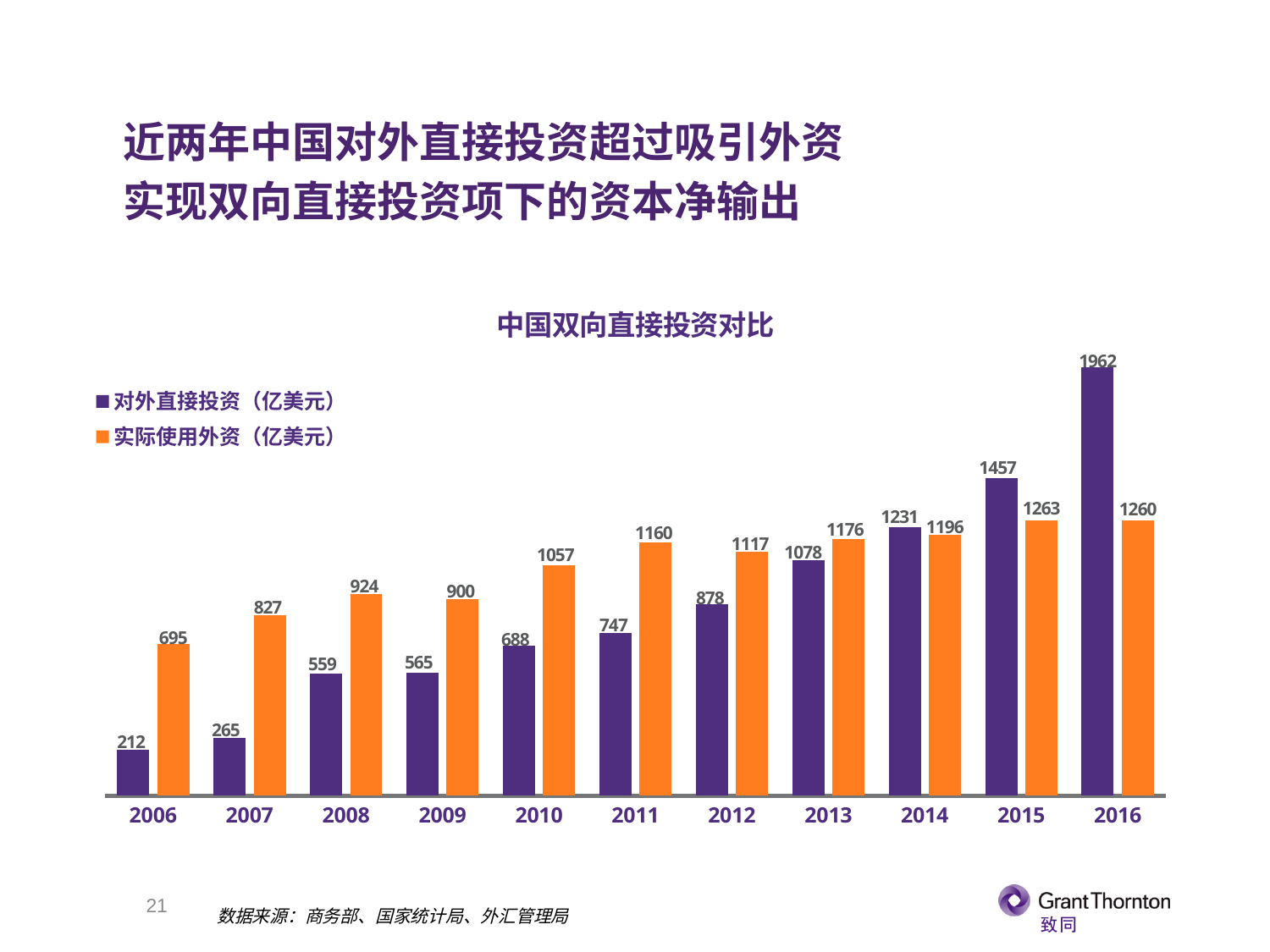
What is the value of 对外直接投资 (亿美元) in 2016? 1962 How many years are shown on the x axis? 11 In 2012, which is larger: 对外直接投资 or 实际使用外资? 实际使用外资 Which year has the highest value for 对外直接投资 (亿美元)? 2016 Which year has the lowest value for 实际使用外资 (亿美元)? 2006 What kind of chart is shown? Bar chart Does 对外直接投资 (亿美元) rise or fall from 2006 to 2016? Rise What is the value of 实际使用外资 (亿美元) in 2010? 1057 What is the value of 对外直接投资 (亿美元) in 2006? 212 How many series does the legend list? 2 What is the title of the chart? 中国双向直接投资对比 What is the difference between 对外直接投资 and 实际使用外资 in 2016? 702